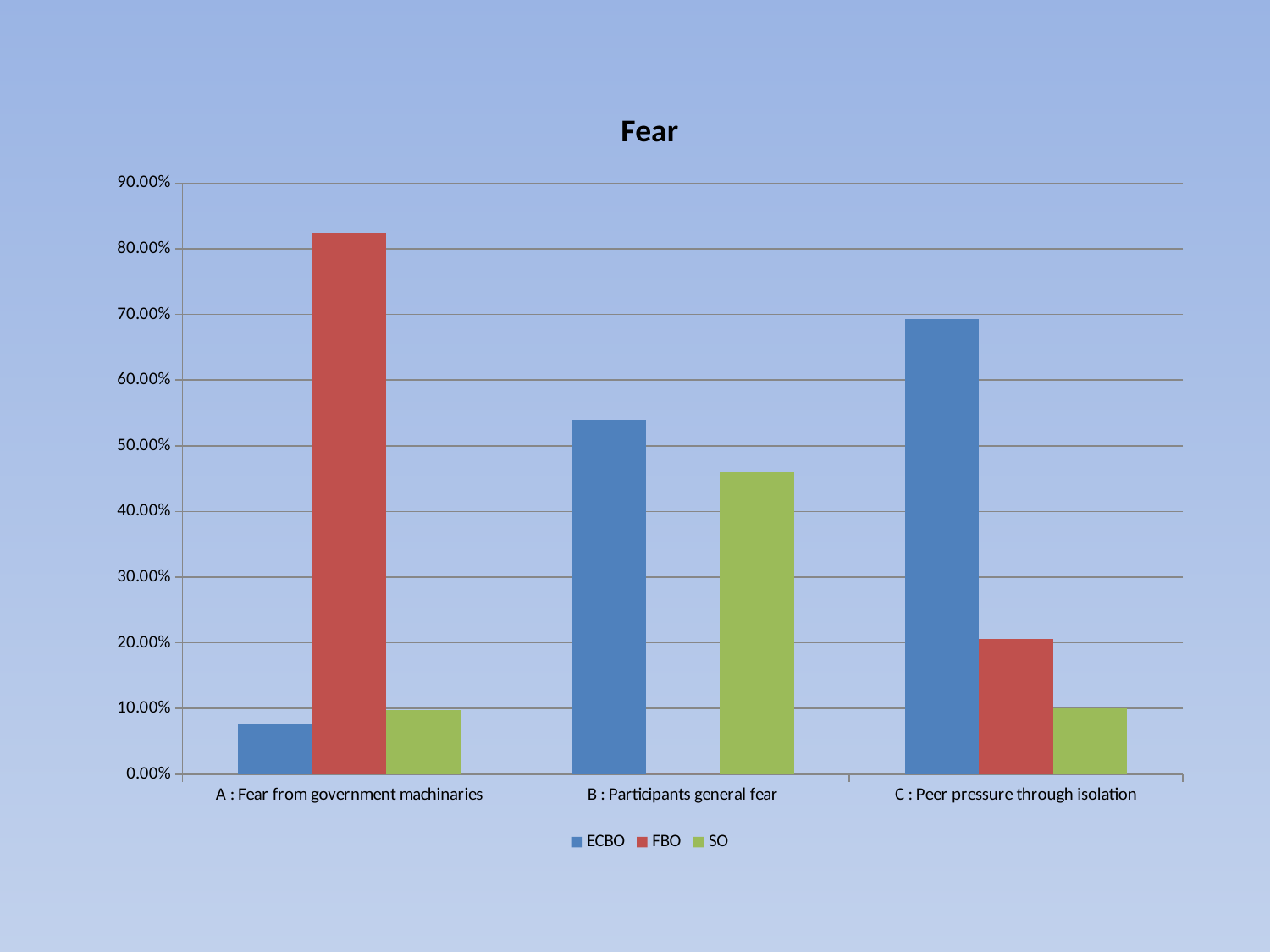
For B : Participants general fear, which is larger, ECBO or SO? ECBO What is the title of the chart? Fear How many categories are shown on the x axis? 3 Which category has the highest ECBO bar? C : Peer pressure through isolation Is the ECBO value for A : Fear from government machinaries greater or less than 10.00%? less What kind of chart is shown on the slide? bar chart For C : Peer pressure through isolation, which is larger, FBO or SO? FBO Which category has the highest FBO bar? A : Fear from government machinaries How many series does the legend list? 3 Is the ECBO value for C : Peer pressure through isolation greater or less than 60.00%? greater Is the SO value for B : Participants general fear greater or less than 40.00%? greater